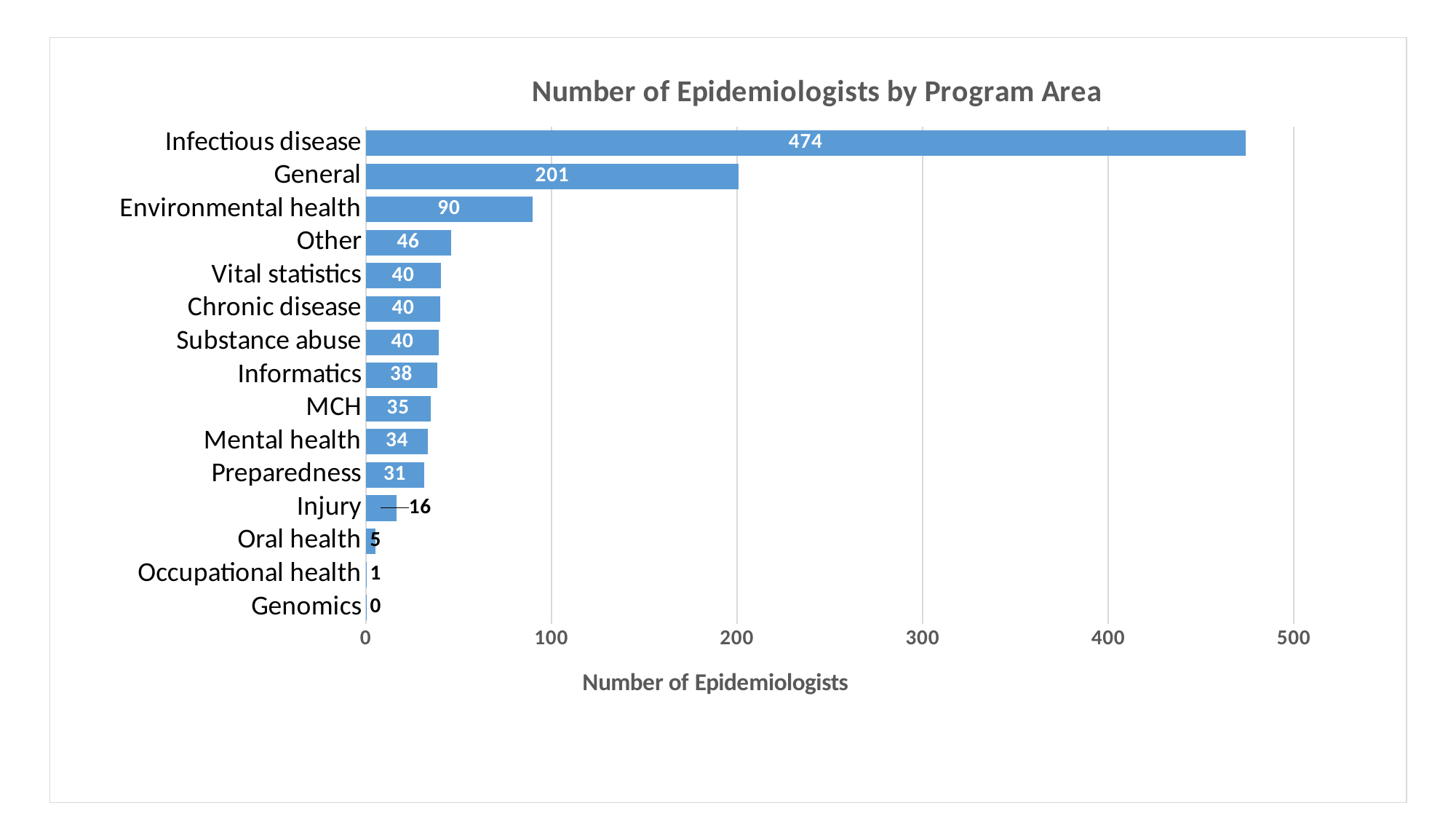
What is the number of epidemiologists for Environmental health? 90 What is the difference between the number of epidemiologists for Other and Preparedness? 15 Is the value for General greater or less than 300? less Which program area has the lowest number of epidemiologists? Genomics What is the difference between the number of epidemiologists for Infectious disease and General? 273 Which has more epidemiologists, General or Environmental health? General What is the number of epidemiologists for Injury? 16 What kind of chart is shown on the slide? Bar chart Which program area has the highest number of epidemiologists? Infectious disease How many program areas are shown in the chart? 15 What is the title of the chart? Number of Epidemiologists by Program Area What is the number of epidemiologists for Infectious disease? 474